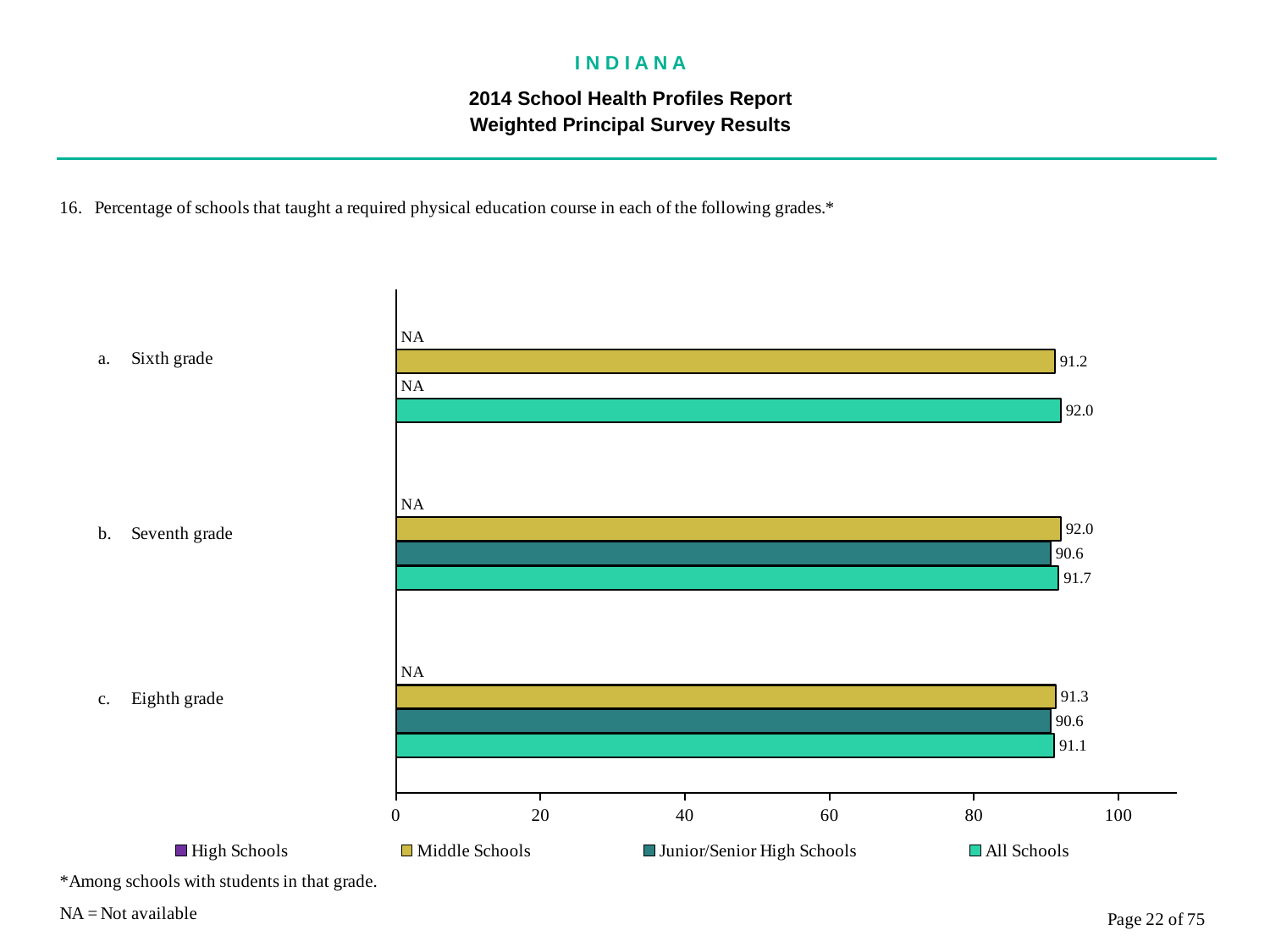
How many grade categories are shown on the chart? 3 How many series does the legend list? 4 Which grade has the lowest value for All Schools? Eighth grade What is shown for High Schools in Sixth grade? NA What kind of chart is shown on the slide? bar chart What is the value for Junior/Senior High Schools in Eighth grade? 90.6 Which grade has the highest value for Middle Schools? Seventh grade What is the value for Middle Schools in Sixth grade? 91.2 What is the difference between the Middle Schools and Junior/Senior High Schools values in Seventh grade? 1.4 What is the value for All Schools in Seventh grade? 91.7 Is the value for All Schools in Sixth grade greater or less than 80? greater Which is larger in Eighth grade: the Middle Schools value or the All Schools value? Middle Schools